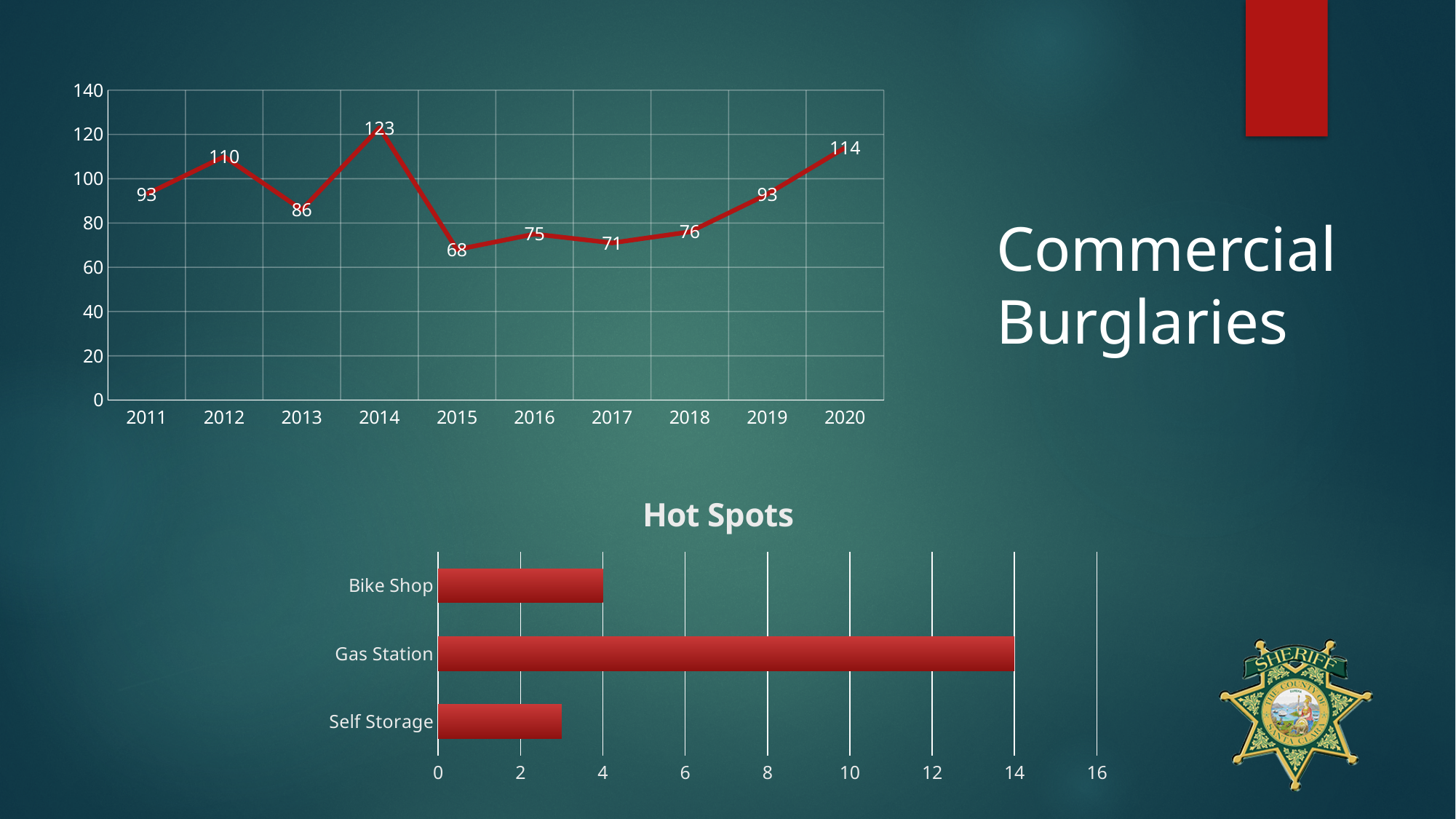
In the top line chart, which year had the lowest value? 2015 In the top line chart, what was the value for 2014? 123 In the Hot Spots chart, which category has the highest value? Gas Station In the top line chart, what is the difference between the 2020 value and the 2019 value? 21 In the top line chart, what was the value for 2015? 68 In the top line chart, which year had the highest value? 2014 In the Hot Spots chart, is the value for Self Storage greater or less than 4? less In the top line chart, how many years are plotted? 10 In the Hot Spots chart, what is the value for Gas Station? 14 What kind of chart is the Hot Spots chart? bar chart In the top line chart, do the values rise or fall from 2017 to 2020? rise In the top line chart, which year has the larger value, 2012 or 2013? 2012